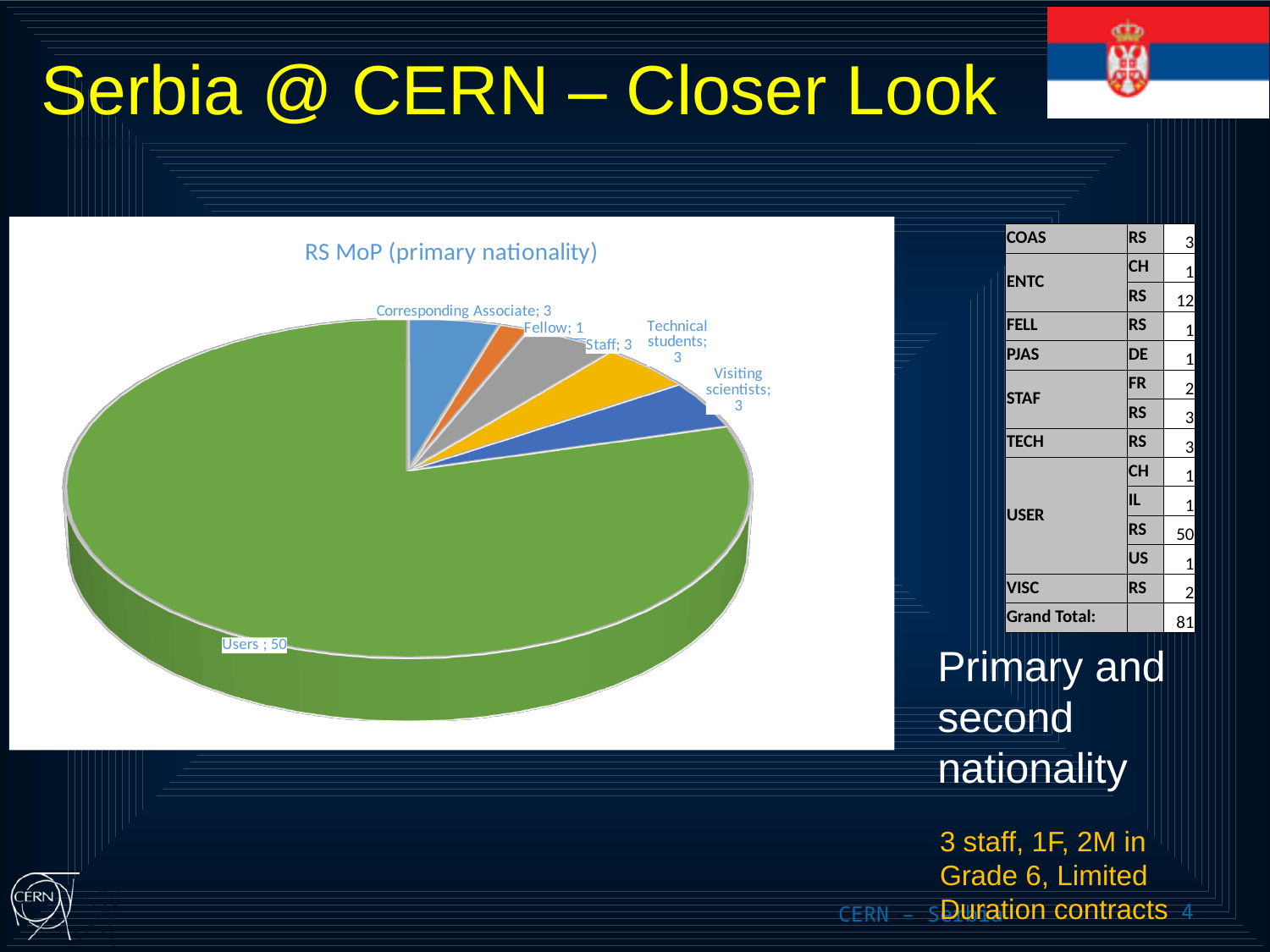
In the pie chart, what is the value for Corresponding Associate? 3 In the pie chart, which is larger: the value for Users or the value for Technical students? Users What is the sum of all the slice values in the pie chart? 63 In the pie chart, what is the value for Visiting scientists? 3 What is the title of the chart on the slide? RS MoP (primary nationality) How many categories (slices) does the pie chart show? 6 In the pie chart, what is the difference between the value for Users and the value for Staff? 47 What kind of chart is shown on the slide? Pie chart Which category has the smallest slice in the pie chart? Fellow In the pie chart, what is the value for Users? 50 In the pie chart, what is the value for Fellow? 1 Which category has the largest slice in the pie chart? Users